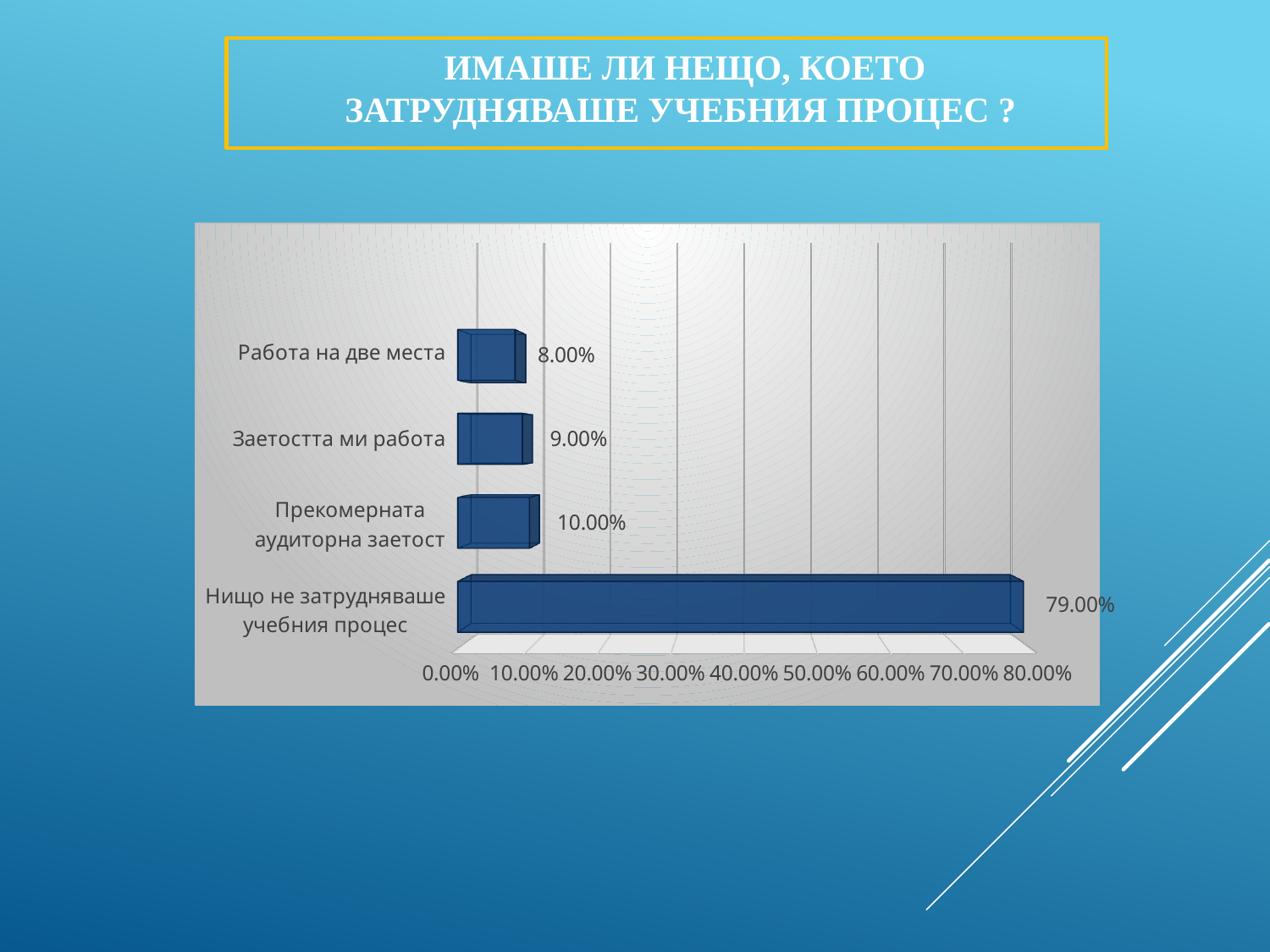
Which category has the highest value? Нищо не затрудняваше учебния процес What is the value for "Нищо не затрудняваше учебния процес"? 79.00% What is the value for "Прекомерната аудиторна заетост"? 10.00% What is the value for "Заетостта ми работа"? 9.00% What is the title of the slide? ИМАШЕ ЛИ НЕЩО, КОЕТО ЗАТРУДНЯВАШЕ УЧЕБНИЯ ПРОЦЕС ? What is the difference between the values for "Нищо не затрудняваше учебния процес" and "Прекомерната аудиторна заетост"? 69.00% How many categories are shown in the chart? 4 Is the value for "Нищо не затрудняваше учебния процес" greater or less than 70.00%? greater What kind of chart is shown on the slide? bar chart Which is larger: the value for "Заетостта ми работа" or the value for "Работа на две места"? Заетостта ми работа Which category has the lowest value? Работа на две места What is the value for "Работа на две места"? 8.00%